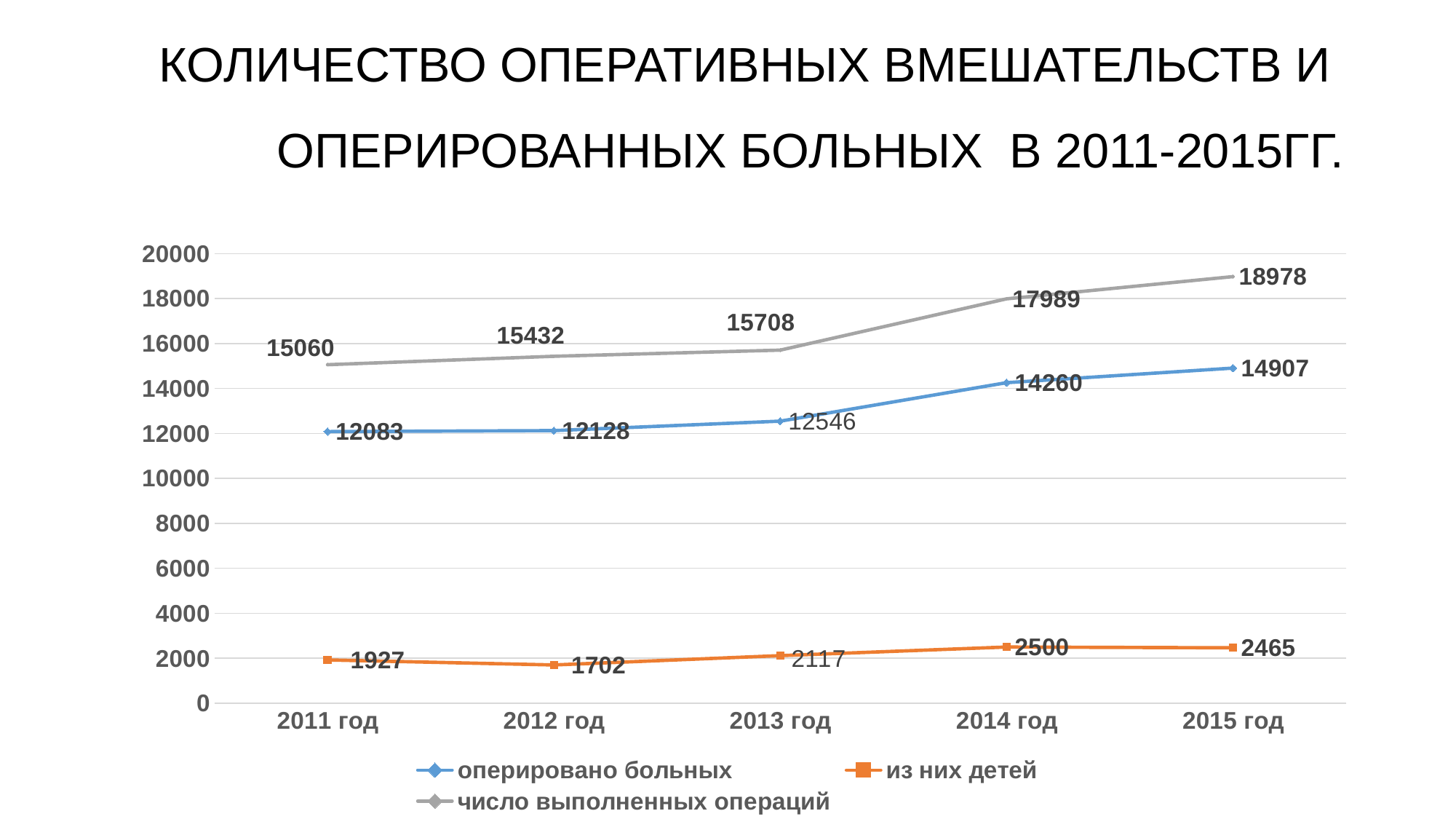
What is the value of 'оперировано больных' for 2014 год? 14260 Which is larger: 'оперировано больных' in 2013 год or in 2012 год? 2013 год What is the difference between 'число выполненных операций' in 2015 год and 2011 год? 3918 Which series is drawn in orange? из них детей How many series does the legend list? 3 What is the value of 'из них детей' for 2012 год? 1702 In which year is 'из них детей' lowest? 2012 год In which year is 'число выполненных операций' highest? 2015 год How many years are plotted along the x axis? 5 What type of chart is shown on the slide? line chart What is the value of 'число выполненных операций' for 2013 год? 15708 Does 'число выполненных операций' generally rise or fall from 2011 год to 2015 год? rise